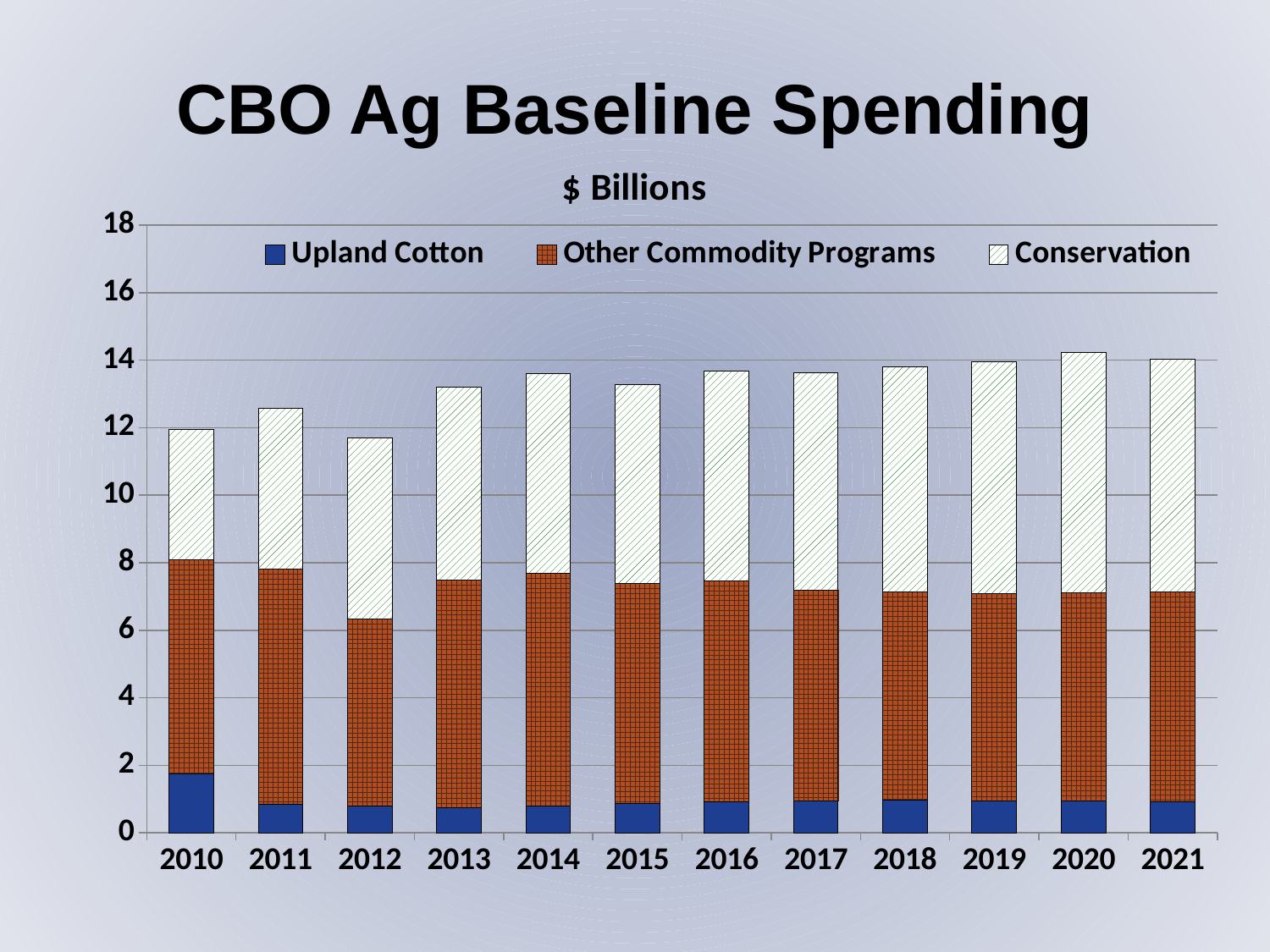
What unit is given in the chart's subtitle? $ Billions How many series does the legend list? 3 How many years are shown along the x axis? 12 Is the total spending for 2020 greater or less than 14? greater Is the total spending for 2012 greater or less than 12? less Which series is shown at the bottom of each stacked bar? Upland Cotton Is the total spending for 2013 greater or less than 12? greater What kind of chart is shown on the slide? Stacked bar chart Do the total bar heights generally rise or fall from 2012 to 2020? rise Which year has the larger total spending, 2012 or 2013? 2013 In which year is the Upland Cotton segment the largest? 2010